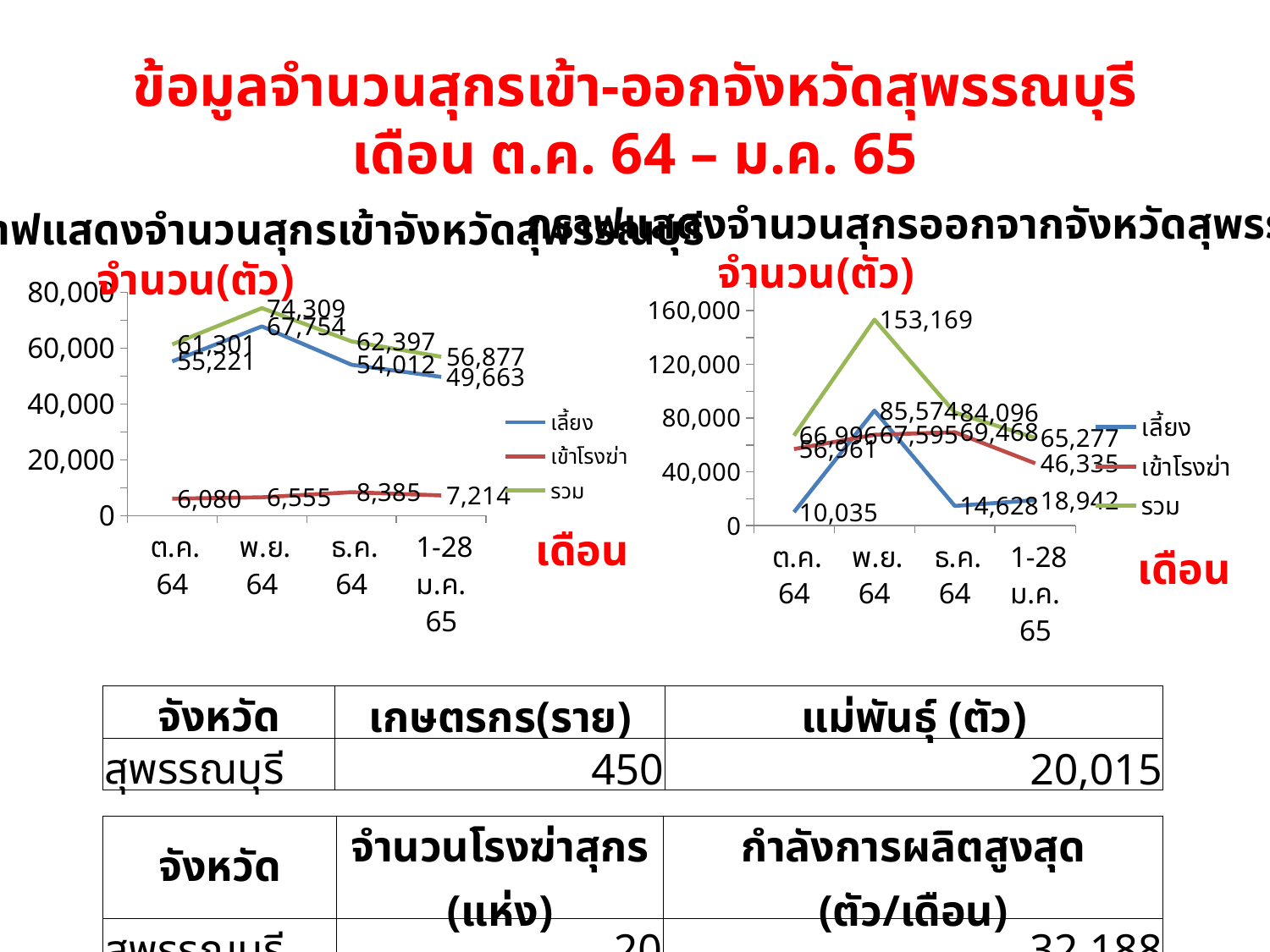
In the left chart, what is the difference between the รวม values for พ.ย. 64 and 1-28 ม.ค. 65? 17,432 In the right chart, what is the value of เลี้ยง for ต.ค. 64? 10,035 How many series does the legend of the left chart list? 3 What type of chart is the left chart on the slide? line chart In the left chart, what is the value of เข้าโรงฆ่า for ธ.ค. 64? 8,385 In the right chart, which is larger for ธ.ค. 64: เลี้ยง or เข้าโรงฆ่า? เข้าโรงฆ่า In the right chart, is the value of เลี้ยง for พ.ย. 64 greater or less than 80,000? greater In the left chart, which month has the highest value for เลี้ยง? พ.ย. 64 In the right chart, which month has the lowest value for เข้าโรงฆ่า? 1-28 ม.ค. 65 How many months are shown on the x axis of the right chart? 4 In the right chart, what is the value of รวม for พ.ย. 64? 153,169 In the left chart, what is the value of รวม for พ.ย. 64? 74,309